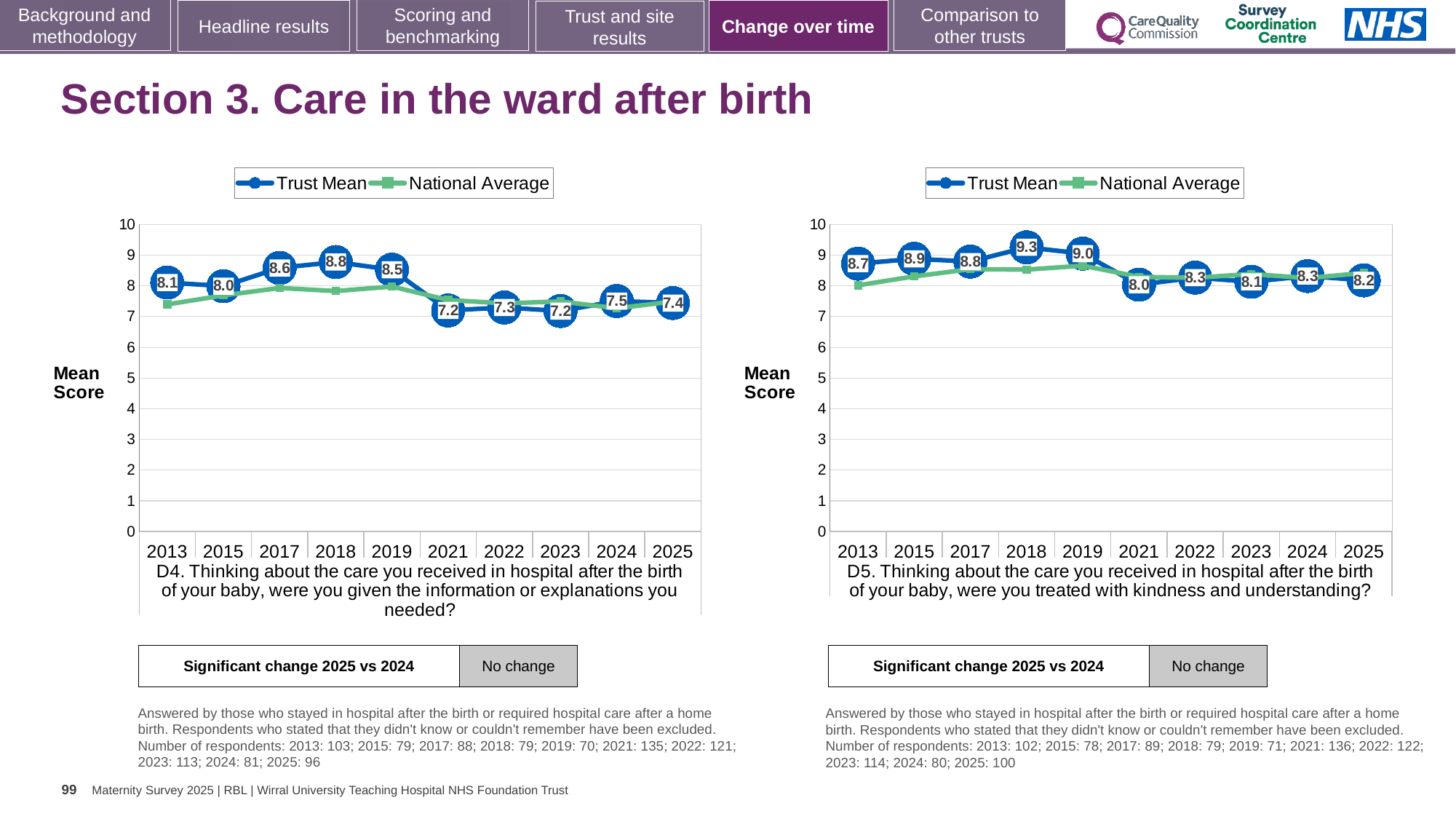
In the D4 chart on the left, is the National Average for 2013 greater or less than 8? less In the D5 chart on the right, how many years are shown on the x axis? 10 In the D5 chart on the right, what is the Trust Mean for 2018? 9.3 How many series does the legend of the D4 chart on the left list? 2 What kind of chart is the D5 chart on the right? Line chart In the D4 chart on the left, what is the difference between the Trust Mean in 2018 and in 2021? 1.6 In the D4 chart on the left, which year has the highest Trust Mean? 2018 In the D4 chart on the left, what is the Trust Mean for 2018? 8.8 In the D5 chart on the right, what is the Trust Mean for 2021? 8.0 In the D5 chart on the right, which year has the lowest Trust Mean? 2021 In the D4 chart on the left, what is the Trust Mean for 2025? 7.4 In the D5 chart on the right, is the Trust Mean for 2015 larger or smaller than the Trust Mean for 2024? larger